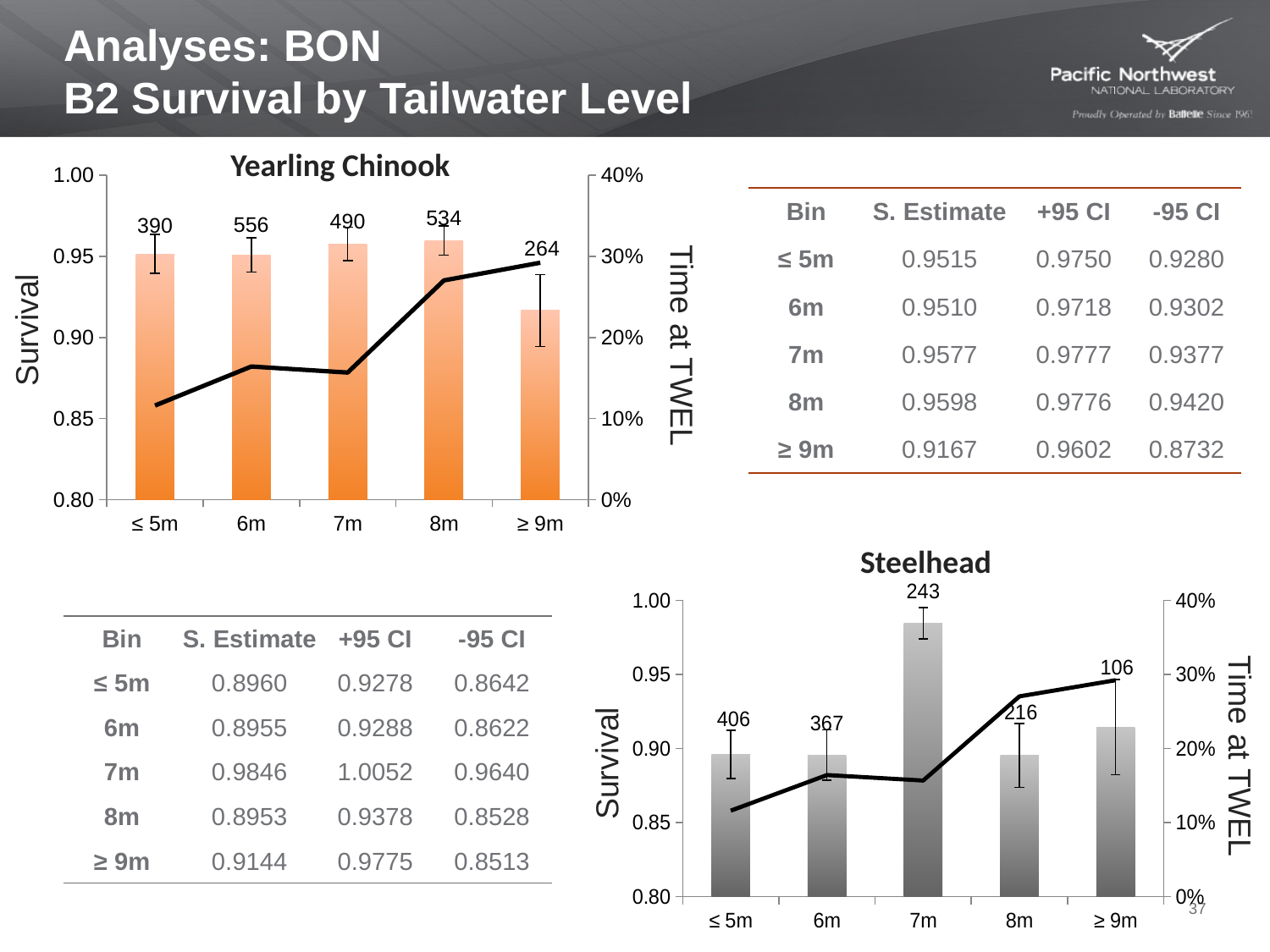
How many tailwater bins are shown on the x axis of the Steelhead chart? 5 In the Yearling Chinook chart, is the survival bar for ≥ 9m greater or less than 0.95? less In the Yearling Chinook chart, which bin has the lowest survival bar? ≥ 9m In the Steelhead chart, is the survival bar for 7m greater or less than 0.95? greater In the Steelhead chart, which bar has the larger printed number, ≤ 5m or 6m? ≤ 5m In the Steelhead chart, which bin has the highest survival bar? 7m In the Steelhead chart, what number is printed above the bar for the 7m bin? 243 In the Yearling Chinook chart, what number is printed above the bar for the ≥ 9m bin? 264 What kind of chart is the Yearling Chinook chart? bar chart with a line overlay In the Steelhead chart, does the Time at TWEL line rise or fall from ≤ 5m to ≥ 9m? rises In the Steelhead chart, is the Time at TWEL line at ≥ 9m greater or less than 20%? greater In the Yearling Chinook chart, what is the difference between the numbers printed above the 6m and ≤ 5m bars? 166